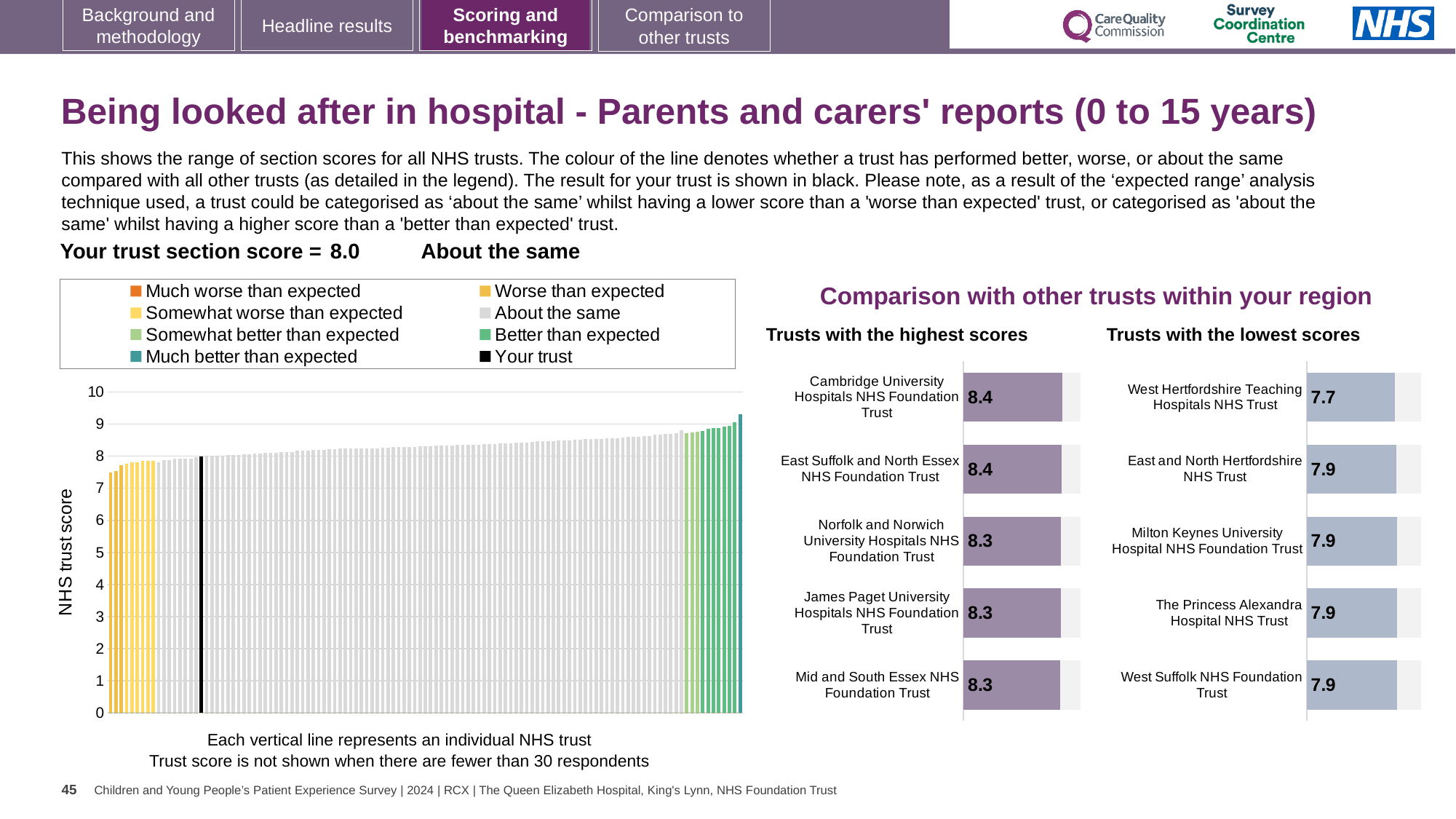
What is the difference between the score for Cambridge University Hospitals NHS Foundation Trust in the highest scores chart and the score for West Hertfordshire Teaching Hospitals NHS Trust in the lowest scores chart? 0.7 How many entries does the legend above the large NHS trust score chart list? 8 In the large NHS trust score chart on the left, what is the section score for your trust (the black line)? 8.0 In the 'Trusts with the lowest scores' chart, how many trusts are shown? 5 In the 'Trusts with the highest scores' chart, which is larger: the score for Cambridge University Hospitals NHS Foundation Trust or for Norfolk and Norwich University Hospitals NHS Foundation Trust? Cambridge University Hospitals NHS Foundation Trust What kind of chart is the large NHS trust score chart on the left? bar chart In the 'Trusts with the lowest scores' chart, what is the score for West Hertfordshire Teaching Hospitals NHS Trust? 7.7 In the large NHS trust score chart on the left, do the trust scores rise or fall from left to right along the x axis? rise In the 'Trusts with the highest scores' chart, what is the score for Mid and South Essex NHS Foundation Trust? 8.3 In the 'Trusts with the highest scores' chart, how many trusts are shown? 5 In the 'Trusts with the highest scores' chart, what is the score for Cambridge University Hospitals NHS Foundation Trust? 8.4 In the 'Trusts with the lowest scores' chart, which trust has the lowest score? West Hertfordshire Teaching Hospitals NHS Trust